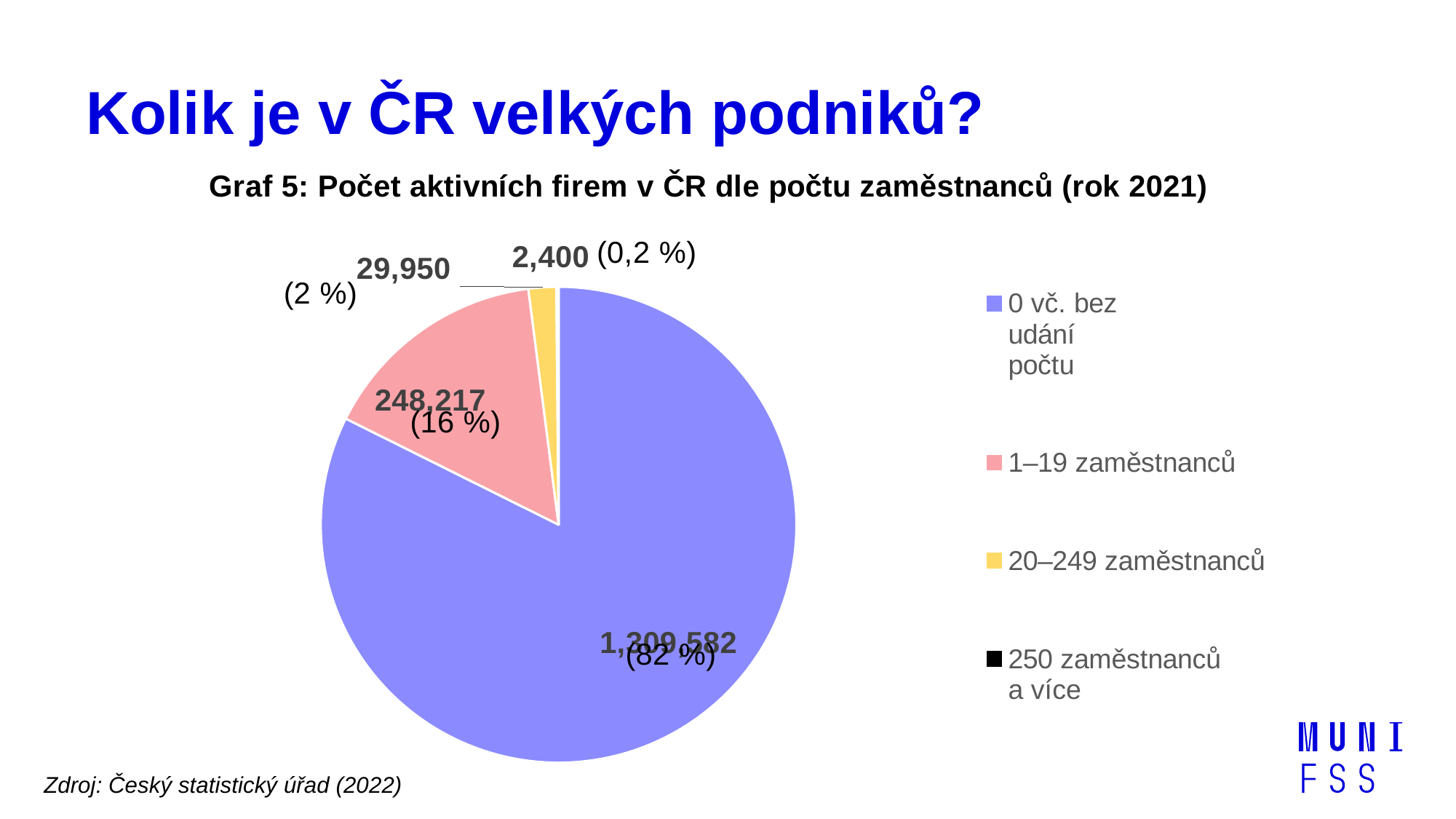
What share of the pie does the category 0 vč. bez udání počtu represent? 82 % What is the difference between the number of firms with 20–249 zaměstnanců and those with 250 zaměstnanců a více? 27,550 What share of the pie does the category 1–19 zaměstnanců represent? 16 % What kind of chart is shown on the slide? pie chart What share of the pie does the category 250 zaměstnanců a více represent? 0,2 % What is the number of firms in the category 20–249 zaměstnanců? 29,950 Which category has the largest slice of the pie? 0 vč. bez udání počtu How many categories does the pie chart show? 4 Which category has the smallest slice of the pie? 250 zaměstnanců a více Which category has more firms: 1–19 zaměstnanců or 20–249 zaměstnanců? 1–19 zaměstnanců What is the number of firms in the category 1–19 zaměstnanců? 248,217 What is the number of firms in the category 250 zaměstnanců a více? 2,400